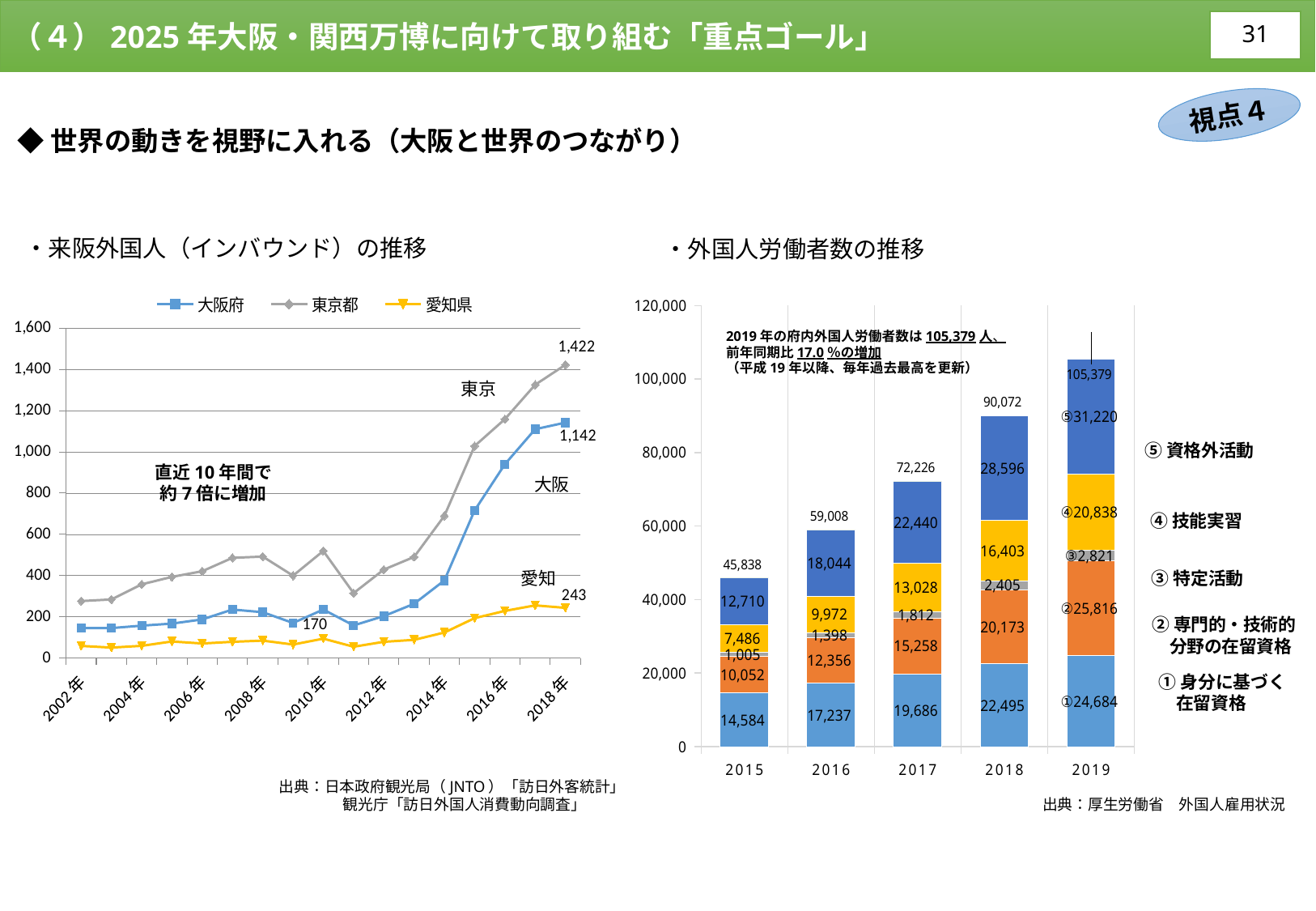
In the left chart (来阪外国人の推移), what is the value for 東京都 in 2018年? 1,422 What kind of chart is the right chart (外国人労働者数の推移)? stacked bar chart In the left chart (来阪外国人の推移), what is the difference between the 2018年 values for 東京都 and 大阪府? 280 In the right chart (外国人労働者数の推移), what is the value of segment ④ 技能実習 in 2018? 16,403 In the left chart (来阪外国人の推移), how many series does the legend list? 3 In the right chart (外国人労働者数の推移), how many years are shown on the x axis? 5 In the right chart (外国人労働者数の推移), what is the difference between the totals for 2018 and 2017? 17,846 In the right chart (外国人労働者数の推移), what is the total for 2019? 105,379 In the left chart (来阪外国人の推移), which series has the lowest value in 2018年? 愛知県 In the left chart (来阪外国人の推移), what is the value for 大阪府 in 2018年? 1,142 In the left chart (来阪外国人の推移), what is the value for 愛知県 in 2018年? 243 In the left chart (来阪外国人の推移), is the value for 大阪府 in 2016年 greater or less than 800? greater